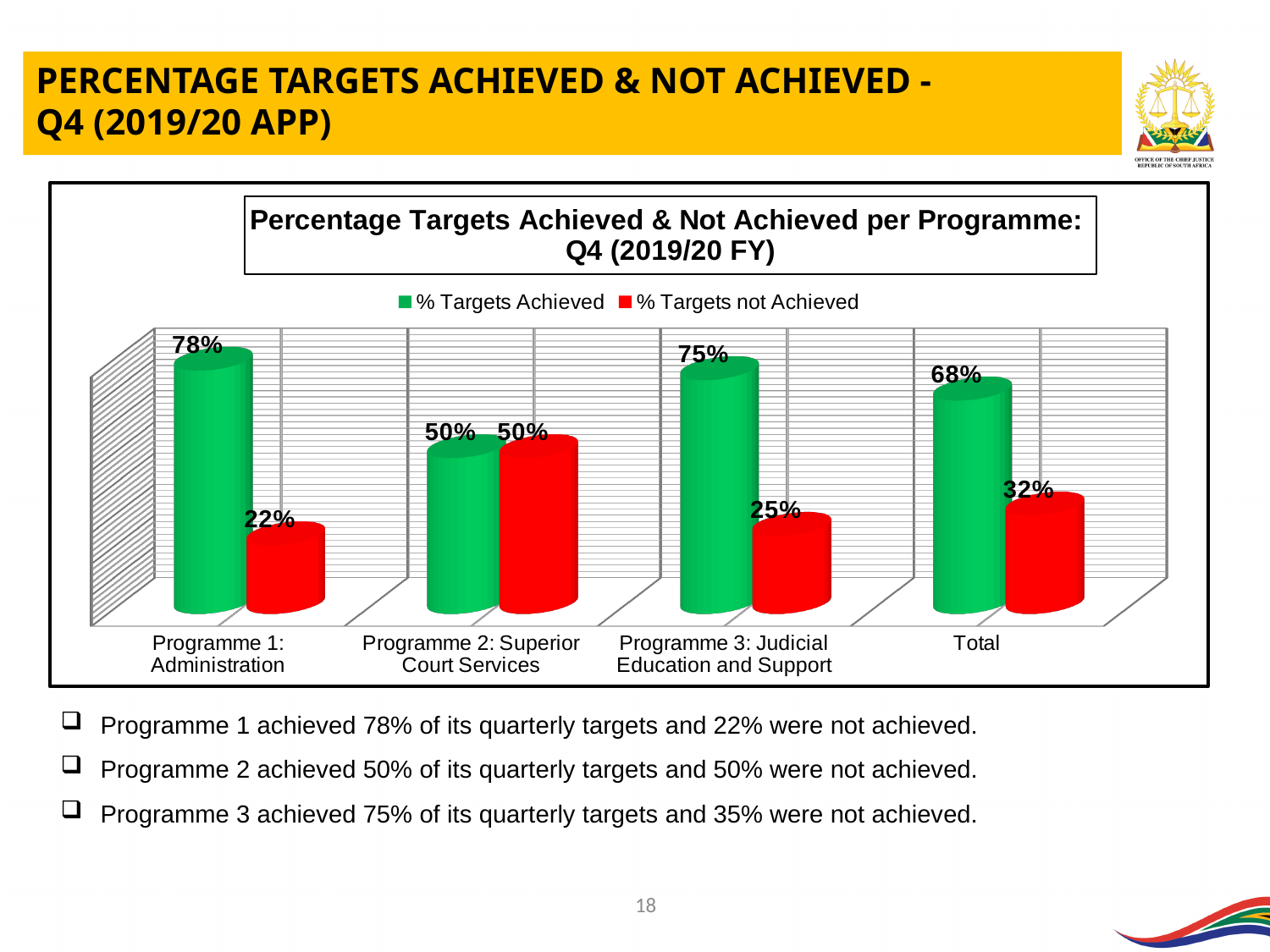
What colour represents the % Targets not Achieved series in the chart? Red What kind of chart is shown on the slide? Bar chart What is the difference between the % Targets Achieved and % Targets not Achieved values for Programme 3: Judicial Education and Support? 50% What is the % Targets Achieved value for Programme 1: Administration? 78% Which category has the highest % Targets Achieved value? Programme 1: Administration What is the % Targets not Achieved value for Programme 2: Superior Court Services? 50% Which category has the lowest % Targets not Achieved value? Programme 1: Administration Which is larger for Total: % Targets Achieved or % Targets not Achieved? % Targets Achieved What is the % Targets Achieved value for Total? 68% How many series does the chart legend list? 2 What is the % Targets not Achieved value for Programme 3: Judicial Education and Support? 25% How many categories are shown on the x axis of the chart? 4